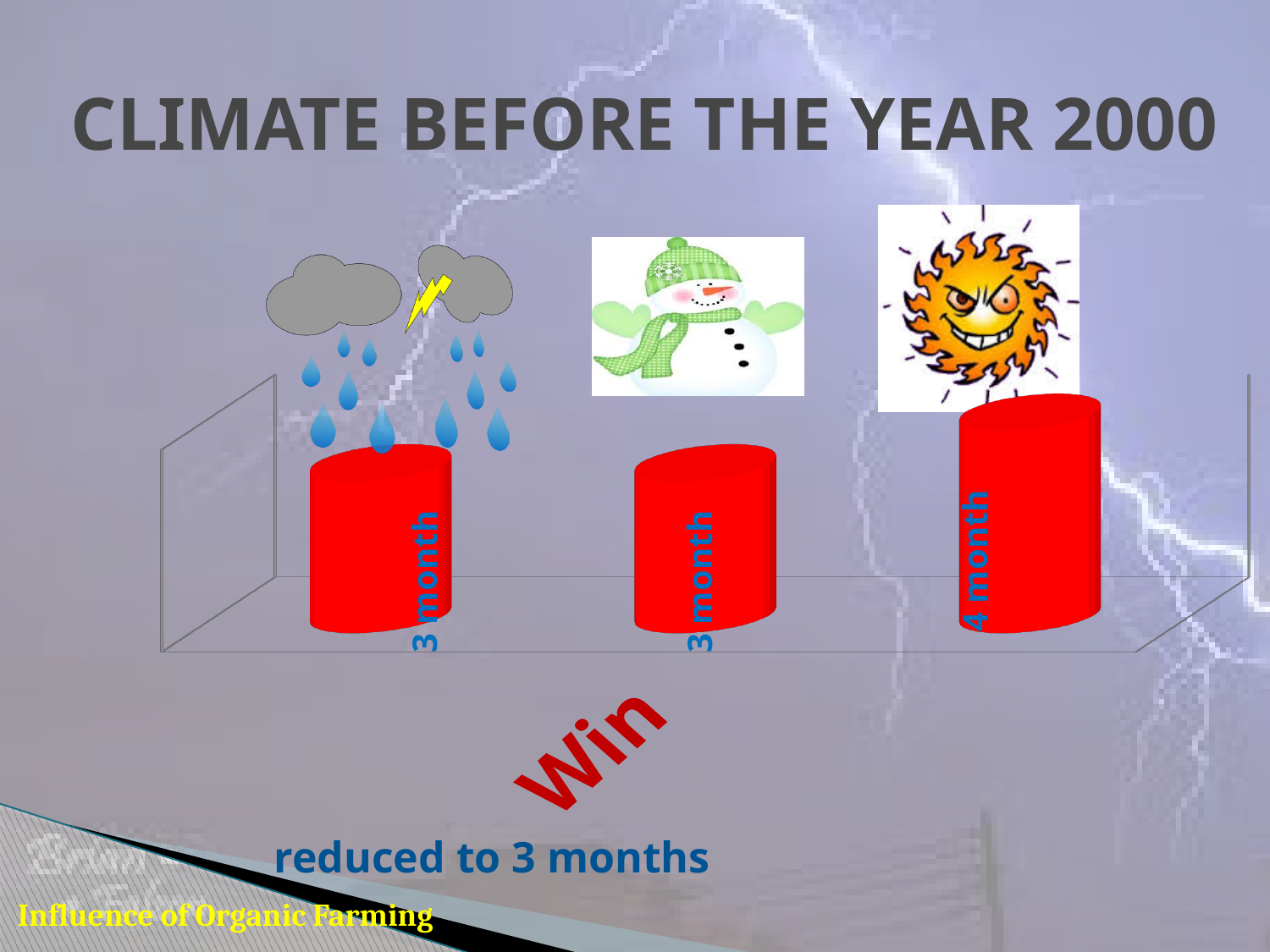
What kind of chart is shown on the slide? bar chart What is the value printed on the first (leftmost) bar, under the rain cloud? 3 month Do the bar values rise or fall from left to right across the chart? rise What is the title of the slide containing the chart? CLIMATE BEFORE THE YEAR 2000 What is the value printed on the third (rightmost) bar, under the sun? 4 month Which bar is the tallest? the rightmost bar (under the sun), 4 month What is the value printed on the middle bar, under the snowman? 3 month Which is larger, the value of the bar under the sun or the bar under the snowman? the bar under the sun How many bars does the chart show? 3 What colour are the bars in the chart? red By how many months does the rightmost bar exceed the leftmost bar? 1 month